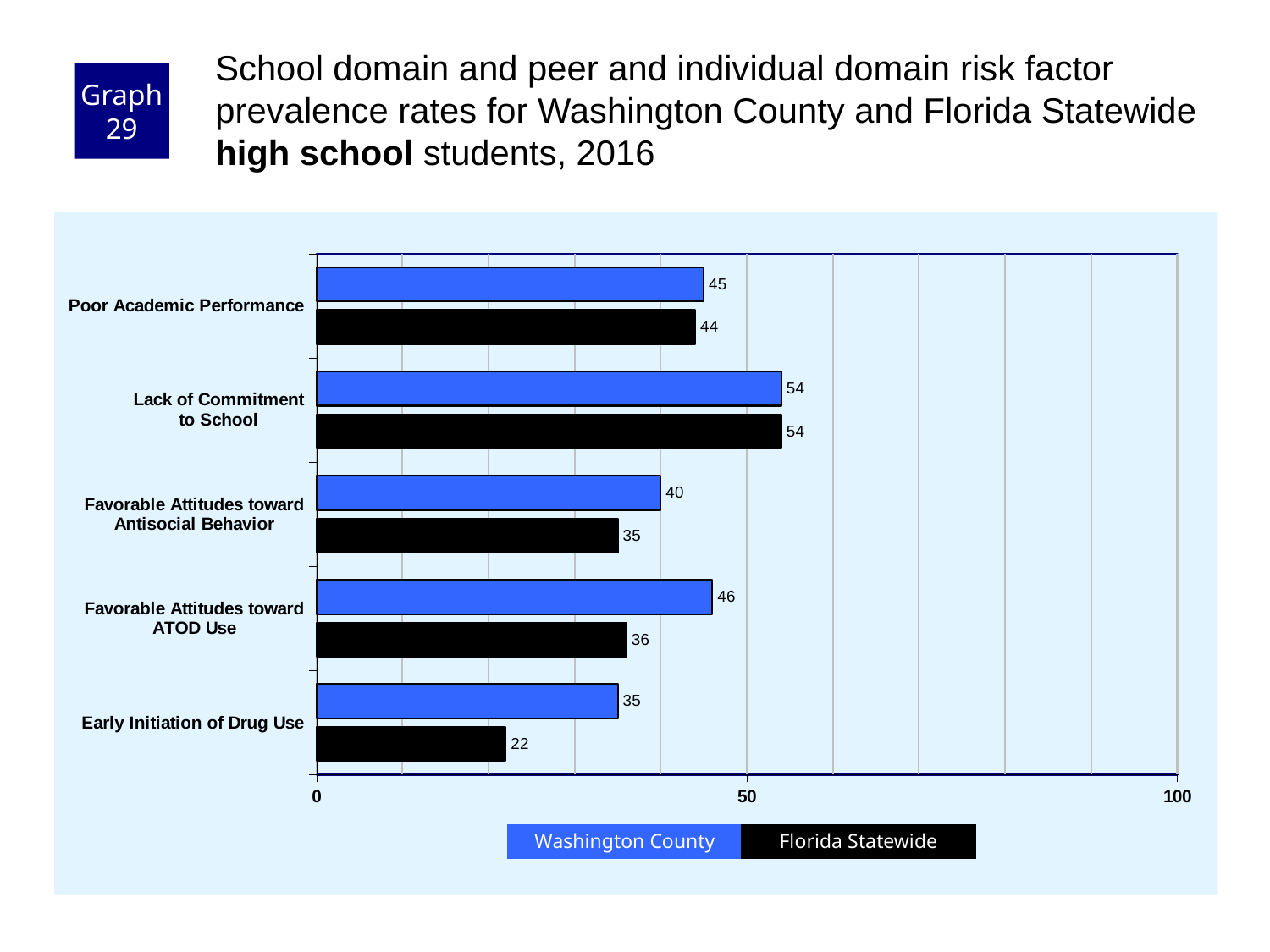
How many series does the legend list? 2 Which risk factor has the lowest Florida Statewide value? Early Initiation of Drug Use Which risk factor has the highest Washington County value? Lack of Commitment to School What is the difference between the Washington County and Florida Statewide values for Favorable Attitudes toward ATOD Use? 10 What is the difference between the Washington County and Florida Statewide values for Early Initiation of Drug Use? 13 How many risk factor categories are shown on the chart? 5 What is the Florida Statewide value for Favorable Attitudes toward ATOD Use? 36 For Favorable Attitudes toward Antisocial Behavior, which is larger: the Washington County value or the Florida Statewide value? Washington County What type of chart is shown on the slide? Bar chart What is the Florida Statewide value for Early Initiation of Drug Use? 22 Is the Washington County value for Lack of Commitment to School greater or less than 50? greater What is the Washington County value for Poor Academic Performance? 45